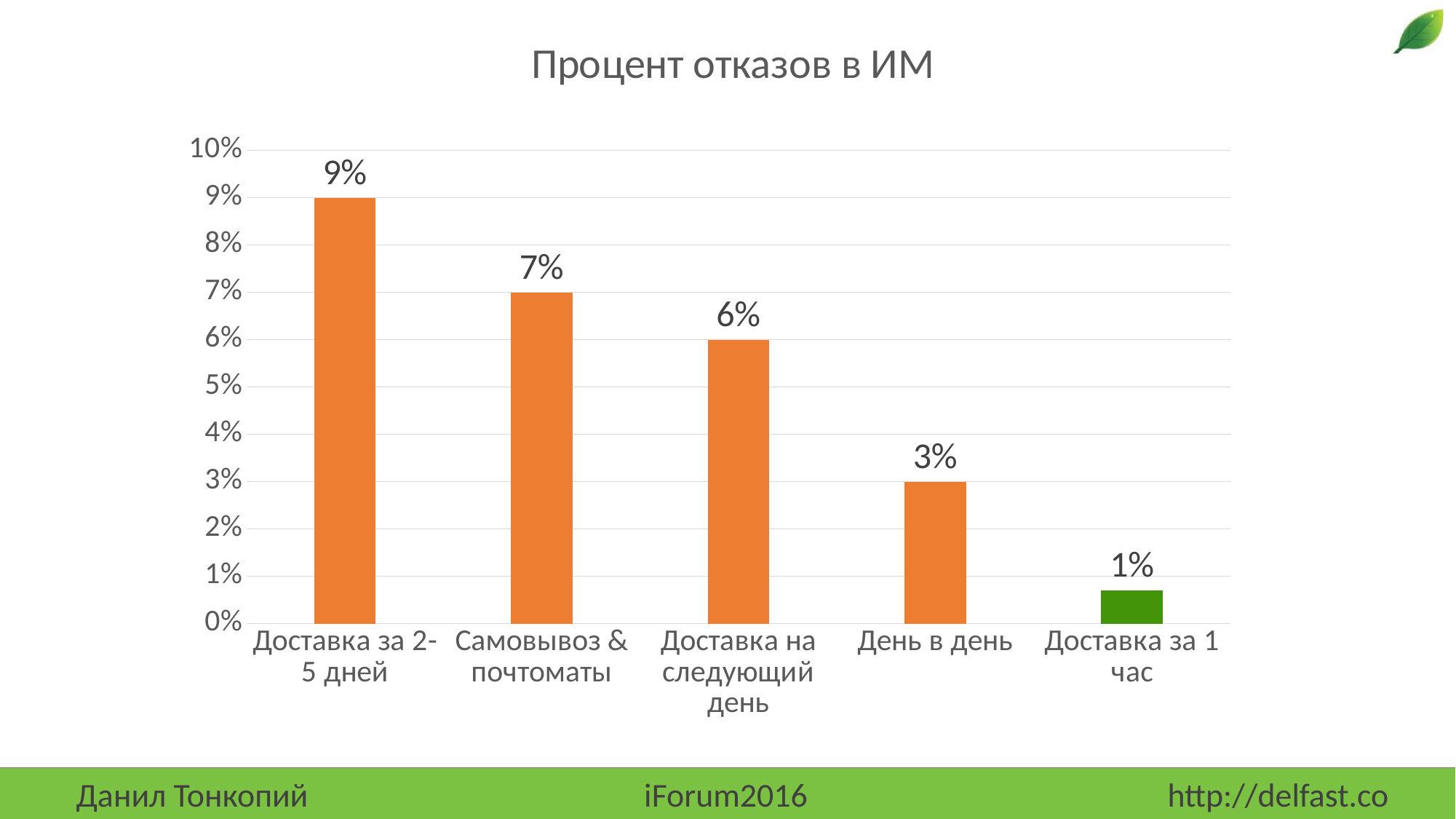
Which category has the highest value? Доставка за 2-5 дней Which is larger, the value for "Самовывоз & почтоматы" or the value for "Доставка на следующий день"? Самовывоз & почтоматы What is the value for "Доставка за 1 час"? 1% How many categories are shown in the chart? 5 What is the value for "Доставка на следующий день"? 6% What is the difference between the values for "Доставка за 2-5 дней" and "День в день"? 6% What is the title of the chart? Процент отказов в ИМ What is the value for "Самовывоз & почтоматы"? 7% What is the value for "День в день"? 3% What is the value for "Доставка за 2-5 дней"? 9% Which category has the lowest value? Доставка за 1 час What kind of chart is shown on the slide? Bar chart